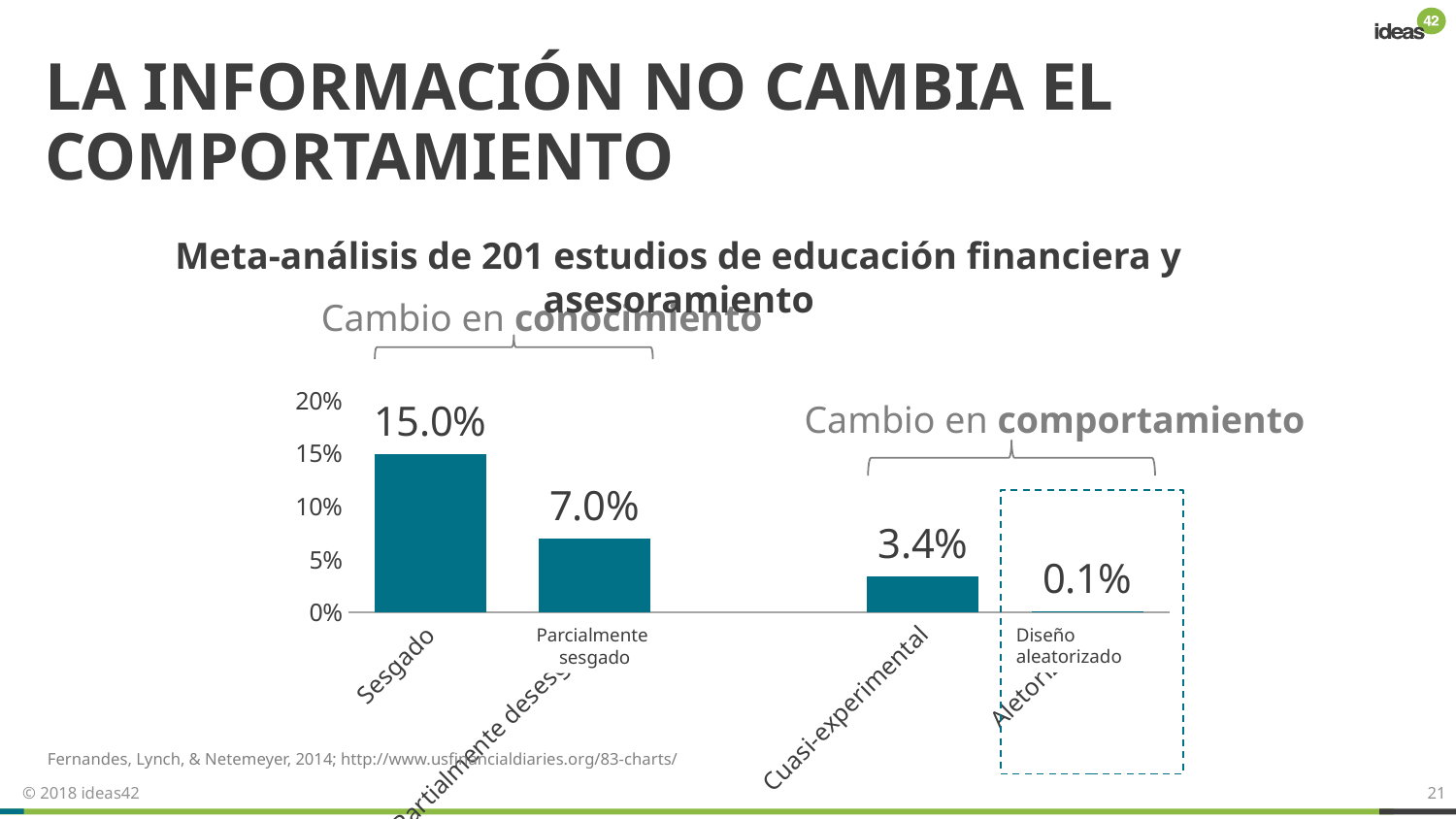
How many bars are shown in the chart? 4 What is the value for Sesgado? 15.0% What is the difference between the values for Sesgado and Parcialmente sesgado? 8.0% What is the value for Diseño aleatorizado? 0.1% Is the value for Sesgado greater or less than 10%? greater What is the difference between the values for Cuasi-experimental and Diseño aleatorizado? 3.3% What is the value for Cuasi-experimental? 3.4% Which is larger, the value for Parcialmente sesgado or the value for Cuasi-experimental? Parcialmente sesgado What kind of chart is shown on the slide? Bar chart Which category has the lowest value? Diseño aleatorizado What is the value for Parcialmente sesgado? 7.0% Which category has the highest value? Sesgado